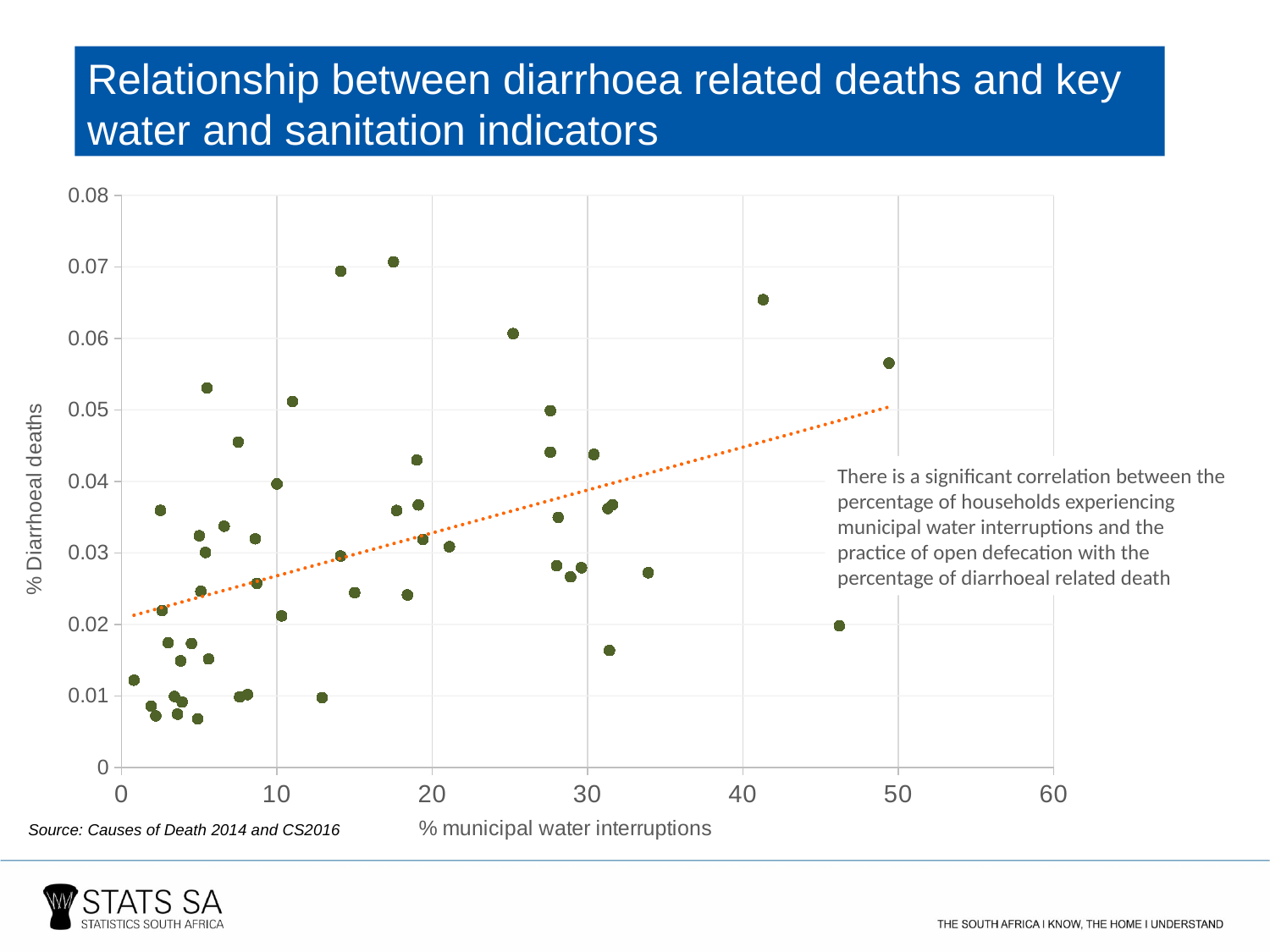
Do any plotted points have % municipal water interruptions greater than 50? No What is the highest value shown on the y axis? 0.08 What is the label of the x axis? % municipal water interruptions Is the % Diarrhoeal deaths value for the point with the largest % municipal water interruptions (near 50) greater or less than 0.05? greater Is the % Diarrhoeal deaths value for the point at roughly 41% municipal water interruptions greater or less than 0.06? greater What kind of chart is shown on the slide? Scatter plot Does the dotted trend line rise or fall as % municipal water interruptions increases? Rises What is the highest value shown on the x axis? 60